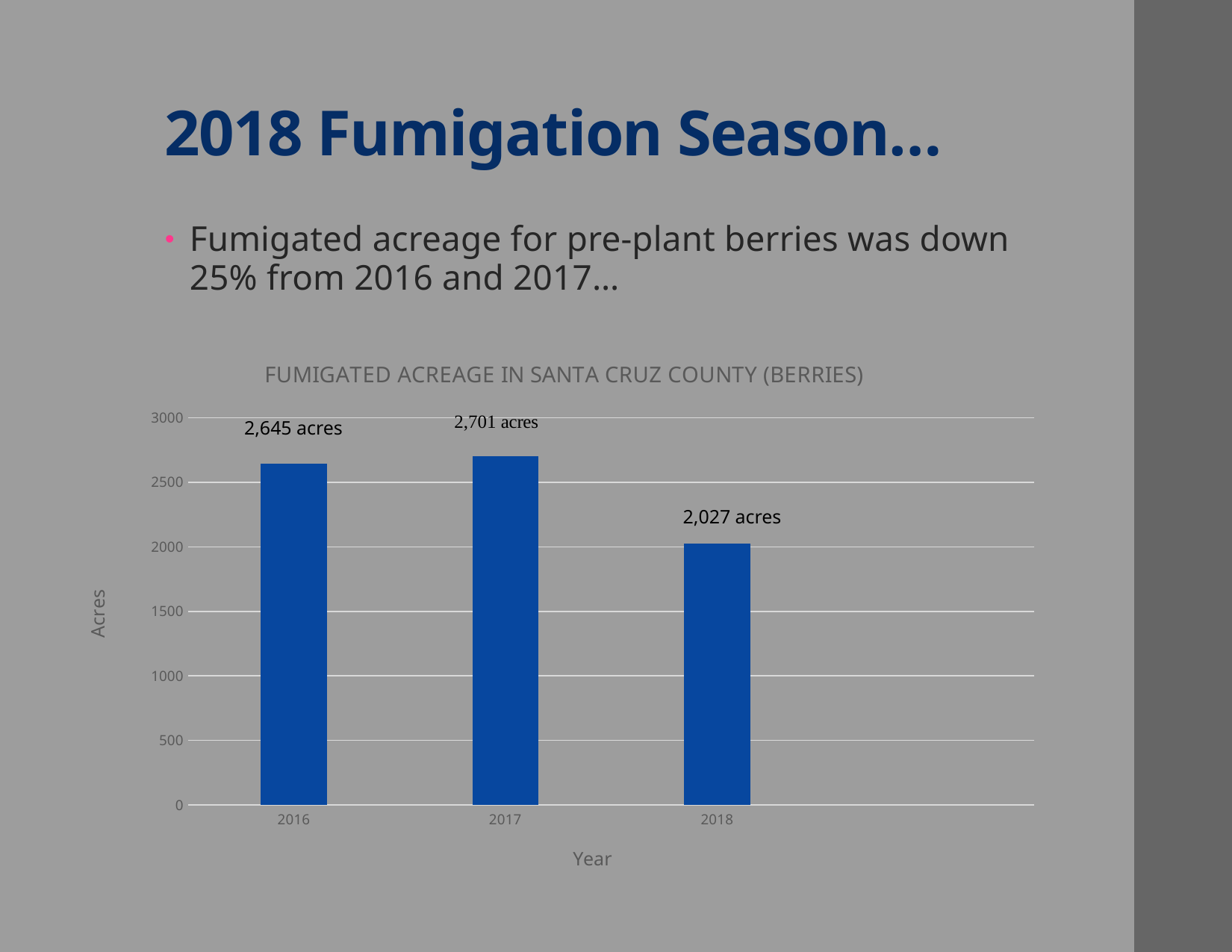
What type of chart is shown on the slide? bar chart What is the difference in fumigated acreage between 2017 and 2016? 56 acres Which year had the highest fumigated acreage? 2017 Which year had more fumigated acreage, 2016 or 2018? 2016 What was the fumigated acreage in 2016? 2,645 acres What was the fumigated acreage in 2017? 2,701 acres Which year had the lowest fumigated acreage? 2018 What is the title of the chart? FUMIGATED ACREAGE IN SANTA CRUZ COUNTY (BERRIES) What is the difference in fumigated acreage between 2017 and 2018? 674 acres How many years are shown in the chart? 3 What was the fumigated acreage in 2018? 2,027 acres Is the fumigated acreage for 2018 greater or less than 2500? less